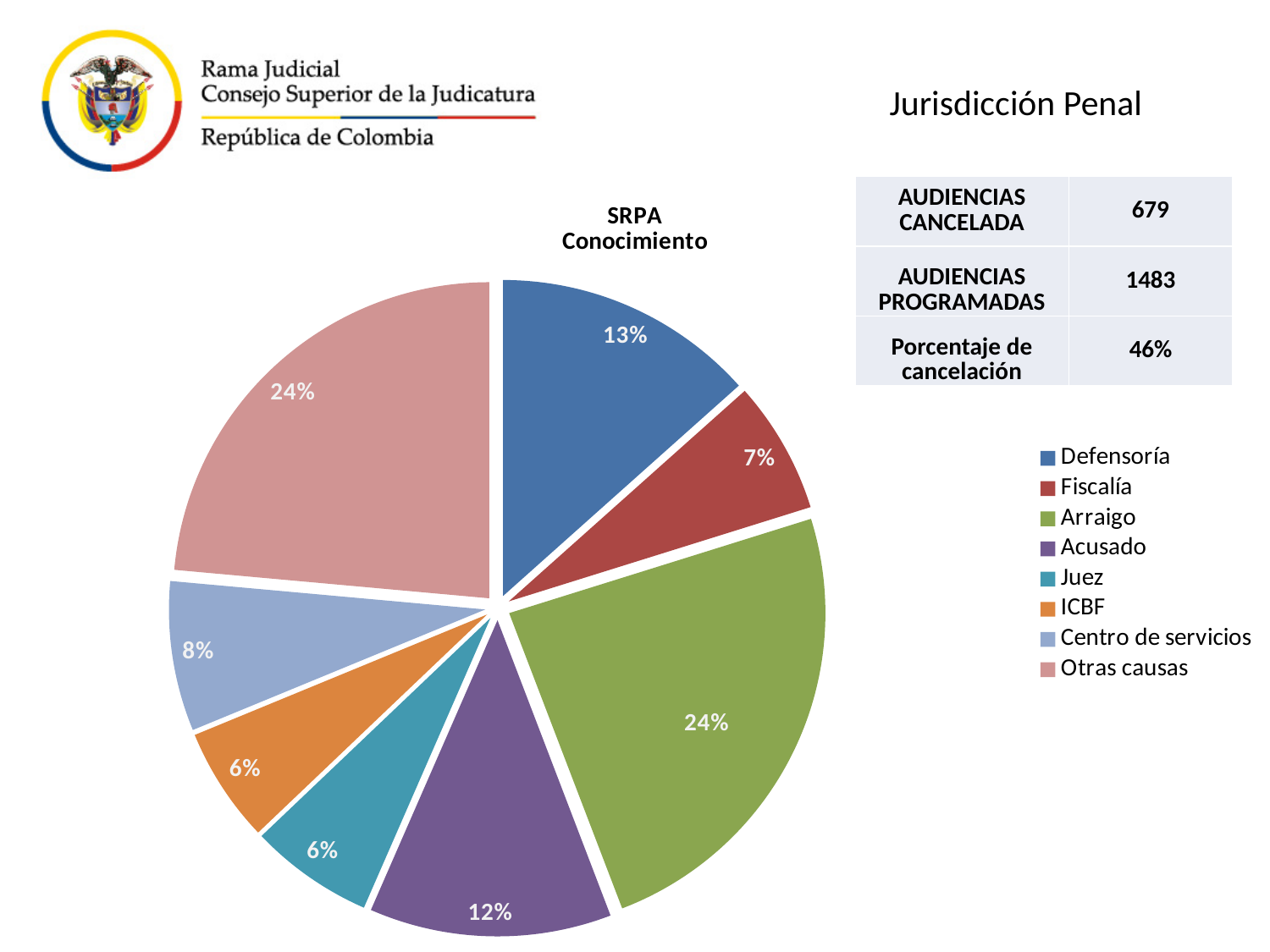
How many slices does the pie chart have? 8 What share does Fiscalía have in the SRPA Conocimiento pie chart? 7% What percentage is shown for Arraigo? 24% What is the title of the chart? SRPA Conocimiento What is the difference in percentage points between Arraigo and Acusado? 12% What percentage is shown for Otras causas? 24% Which is larger, the share for Acusado or the share for Centro de servicios? Acusado Which is larger, the share for Defensoría or the share for Fiscalía? Defensoría What percentage is shown for Acusado? 12% What kind of chart is shown on the slide? Pie chart What percentage is shown for Centro de servicios? 8% What percentage of the pie chart is labelled for Defensoría? 13%